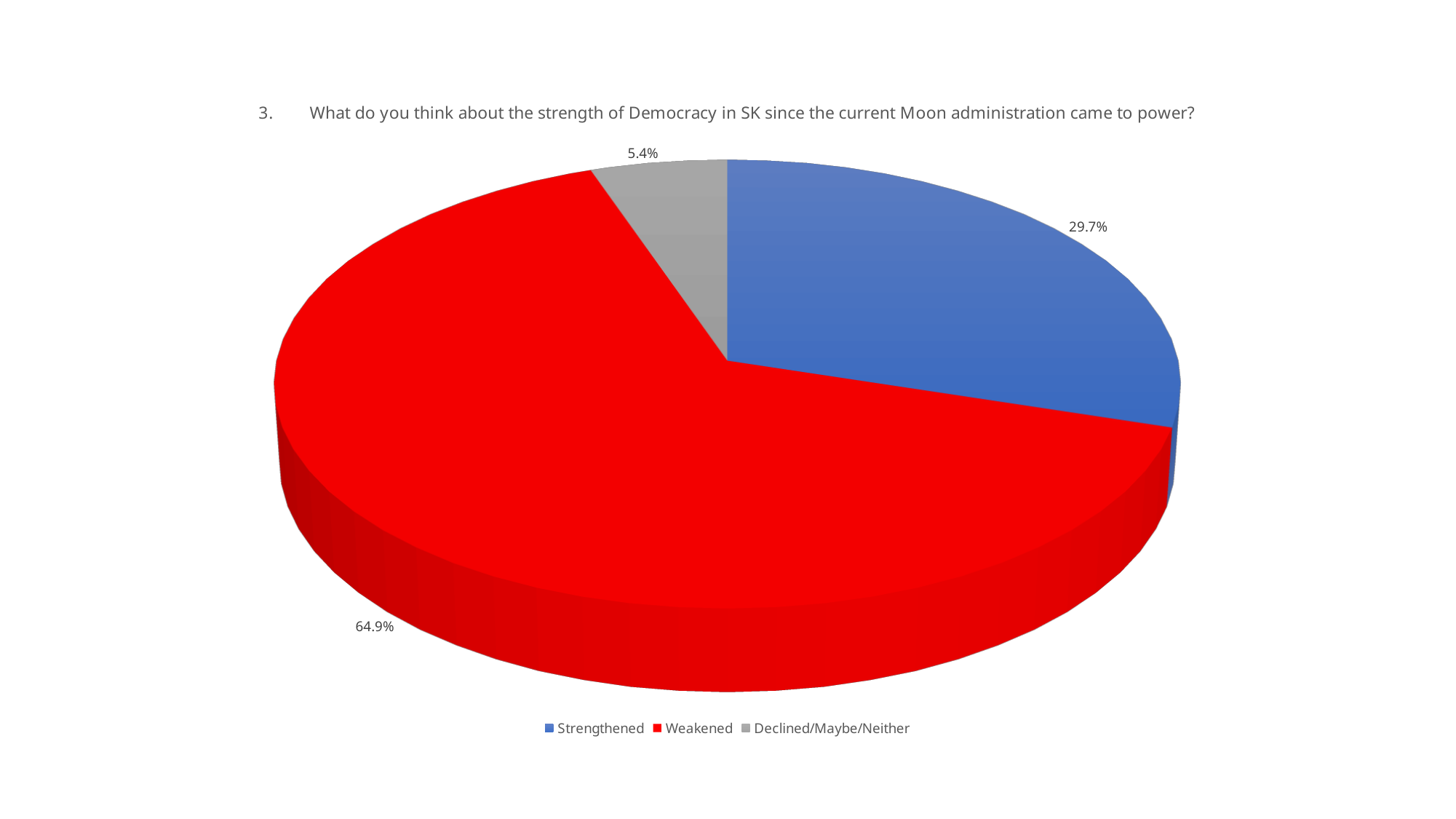
What colour is the "Weakened" slice? Red Which is larger, the share for "Strengthened" or the share for "Declined/Maybe/Neither"? Strengthened Which response has the smallest share of the pie? Declined/Maybe/Neither What percentage of respondents answered "Weakened"? 64.9% What percentage of respondents answered "Declined/Maybe/Neither"? 5.4% What is the difference in percentage points between "Weakened" and "Strengthened"? 35.2 What type of chart is shown on the slide? Pie chart What is the title of the chart? What do you think about the strength of Democracy in SK since the current Moon administration came to power? How many entries does the legend list? 3 How many slices does the pie chart have? 3 What percentage of respondents answered "Strengthened"? 29.7% Which response has the largest share of the pie? Weakened